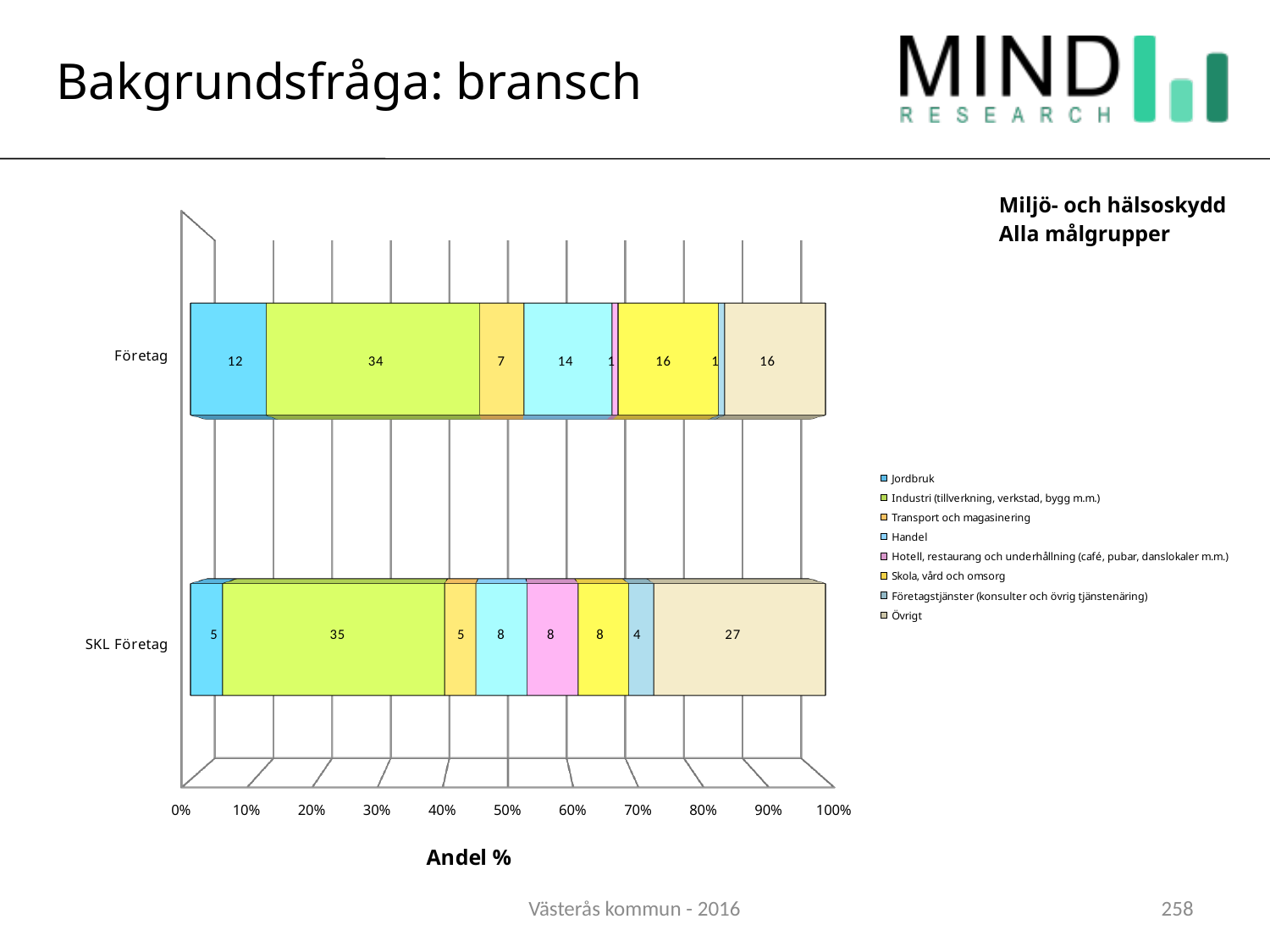
What is the value for Jordbruk in the Företag bar? 12 How many series does the legend list? 8 What is the difference between the Skola, vård och omsorg values for Företag and SKL Företag? 8 What is the value for Handel in the SKL Företag bar? 8 Which is larger: the Jordbruk value for Företag or for SKL Företag? Företag What is the value for Övrigt in the SKL Företag bar? 27 What kind of chart is shown on the slide? Stacked bar chart How many categories are plotted on the vertical axis? 2 What is the value for Industri (tillverkning, verkstad, bygg m.m.) in the Företag bar? 34 What is the difference between the Övrigt values for SKL Företag and Företag? 11 What is the label of the horizontal axis? Andel % Which series has the largest segment in the SKL Företag bar? Industri (tillverkning, verkstad, bygg m.m.)